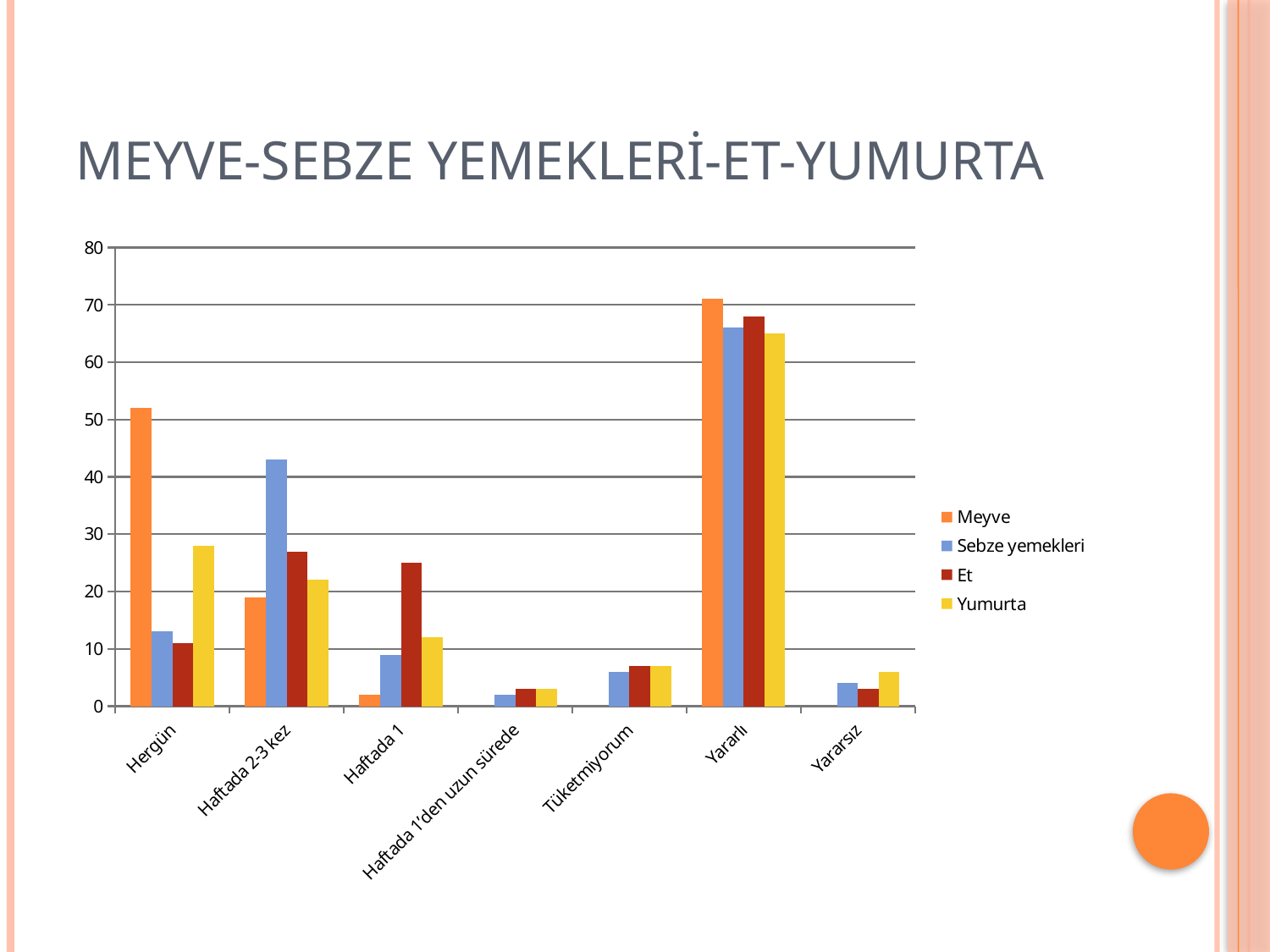
In the Hergün category, which is larger: Meyve or Yumurta? Meyve In the Haftada 1 category, which is larger: Et or Sebze yemekleri? Et Which series has the highest bar in the Haftada 2-3 kez category? Sebze yemekleri What is the title of the slide? MEYVE-SEBZE YEMEKLERİ-ET-YUMURTA Is the value for Et in the Haftada 2-3 kez category greater or less than 30? less Is the value for Meyve in the Hergün category greater or less than 50? greater In which category is the Meyve bar the highest? Yararlı How many series does the legend list? 4 Is the value for Meyve in the Yararlı category greater or less than 60? greater How many categories are shown on the x axis? 7 What kind of chart is shown on the slide? Bar chart